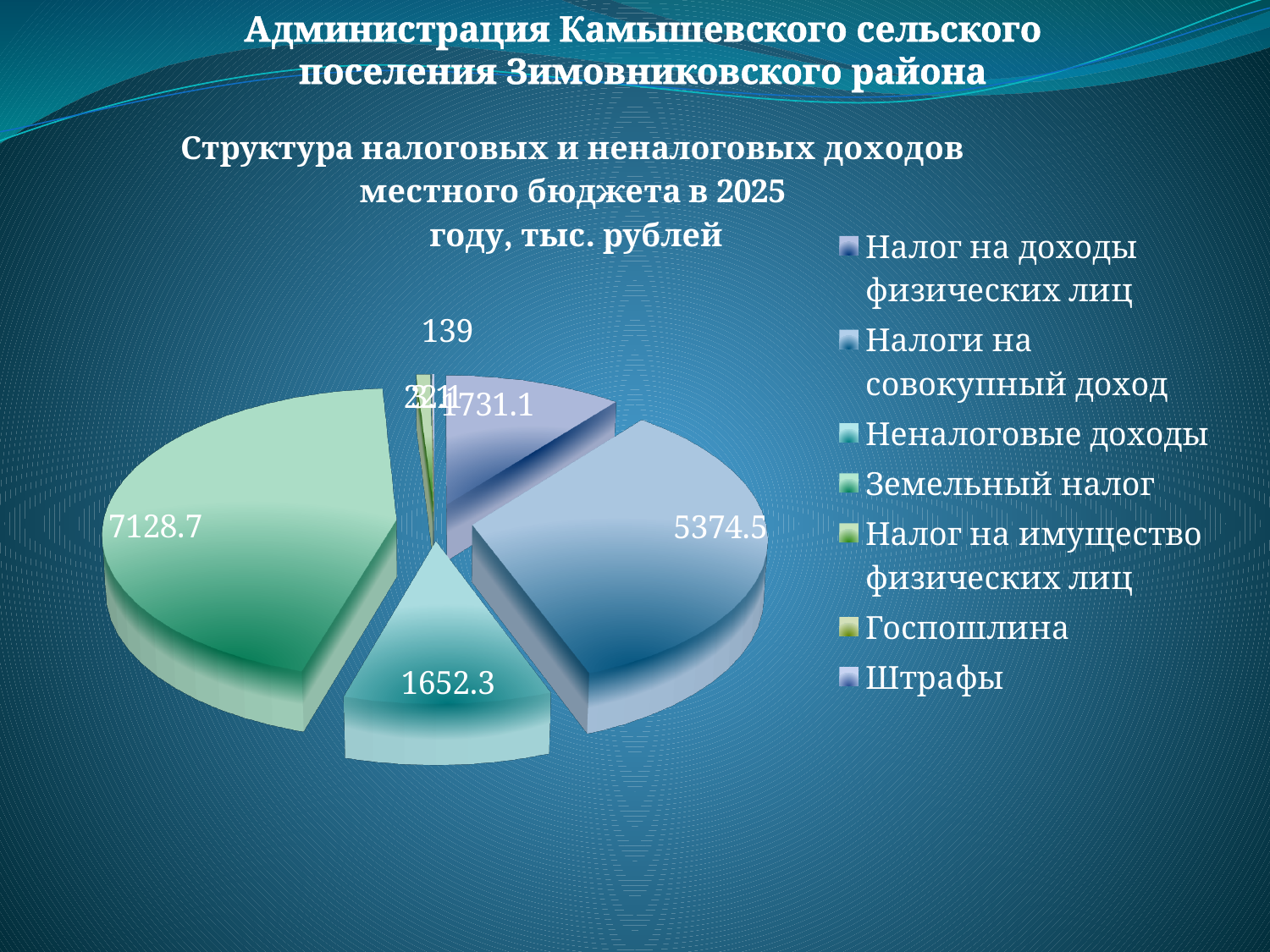
What is the difference between the values for Земельный налог and Налоги на совокупный доход? 1754.2 What is the value for Налоги на совокупный доход? 5374.5 Which is larger: Налог на доходы физических лиц or Неналоговые доходы? Налог на доходы физических лиц How many categories does the legend of the pie chart list? 7 Which category has the largest slice of the pie? Земельный налог What is the value for Земельный налог? 7128.7 What kind of chart is shown on the slide? pie chart In what units are the values of the chart given, according to its title? тыс. рублей What is the difference between the values for Налог на доходы физических лиц and Неналоговые доходы? 78.8 Which is larger: Налоги на совокупный доход or Земельный налог? Земельный налог What is the value for Неналоговые доходы? 1652.3 What is the value for Налог на доходы физических лиц? 1731.1